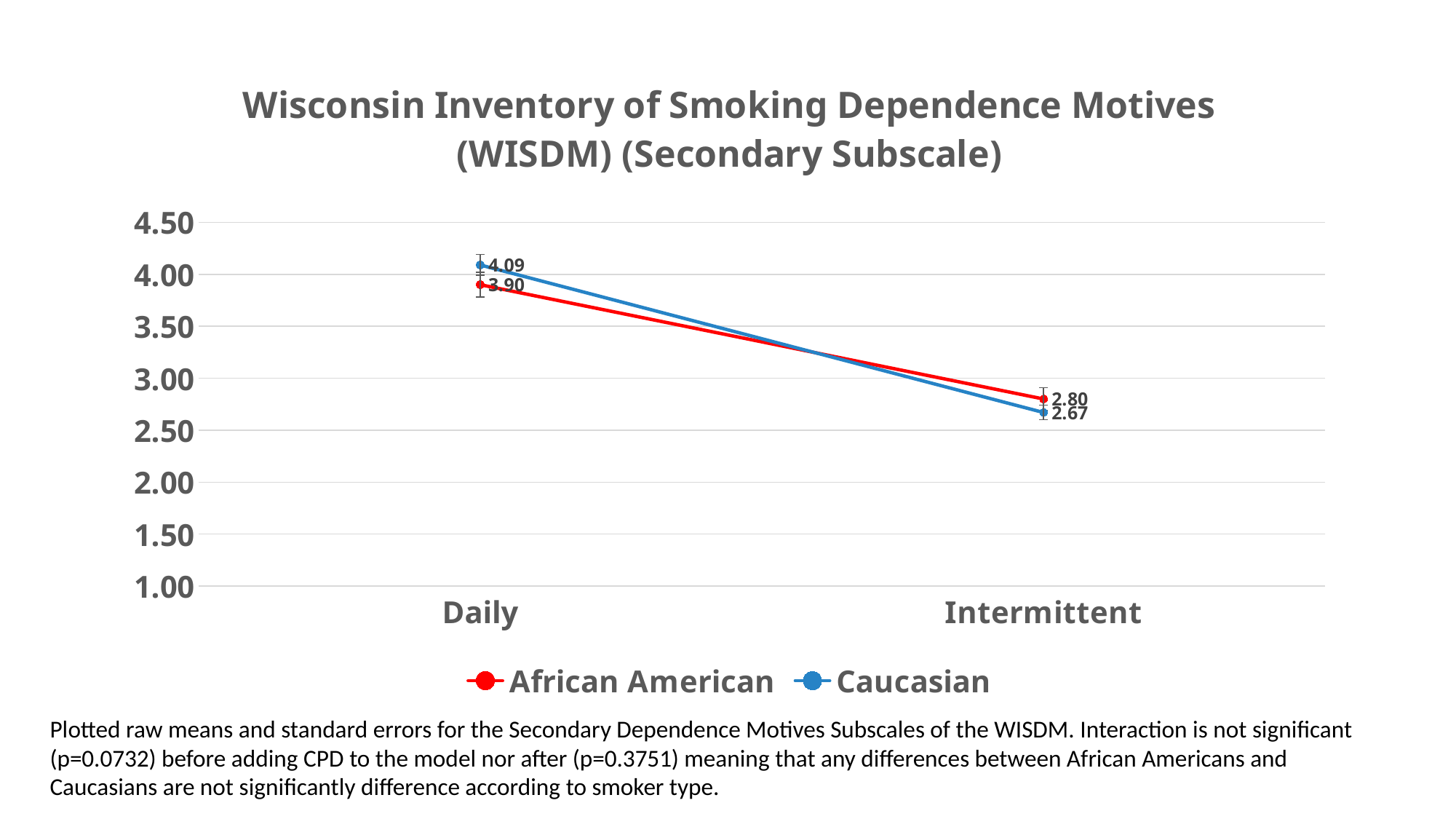
How many categories are shown on the x axis? 2 What is the value for African American at Daily? 3.90 What is the value for African American at Intermittent? 2.80 How many series does the legend list? 2 Which series has the higher value at Intermittent? African American Do the values for Caucasian rise or fall from Daily to Intermittent? fall Which series has the higher value at Daily? Caucasian What is the value for Caucasian at Daily? 4.09 What is the difference between the African American and Caucasian values at Intermittent? 0.13 What is the value for Caucasian at Intermittent? 2.67 What is the difference between the Caucasian and African American values at Daily? 0.19 What kind of chart is shown on the slide? line chart